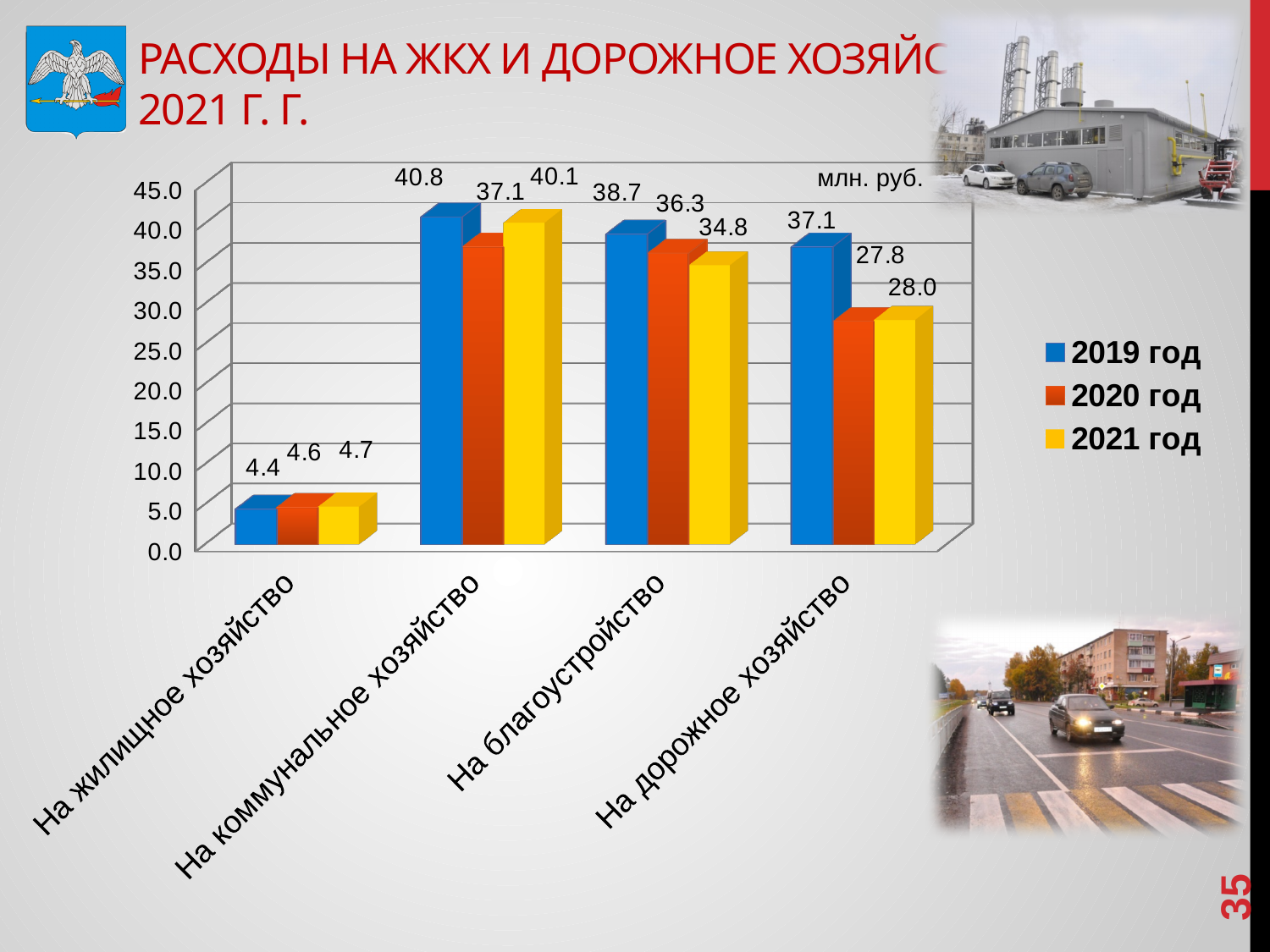
Which category has the lowest value in the 2021 год series? На жилищное хозяйство What is the value for На жилищное хозяйство in the 2019 год series? 4.4 What is the value for На благоустройство in the 2020 год series? 36.3 What kind of chart is shown on the slide? Bar chart Which is larger for На благоустройство: the 2019 год value or the 2021 год value? 2019 год How many series does the legend list? 3 What is the value for На дорожное хозяйство in the 2020 год series? 27.8 How many categories are shown on the x axis of the chart? 4 What is the value for На коммунальное хозяйство in the 2021 год series? 40.1 What unit is indicated for the values in the chart? млн. руб. What is the difference between the 2019 год and 2020 год values for На дорожное хозяйство? 9.3 Which category has the highest value in the 2019 год series? На коммунальное хозяйство